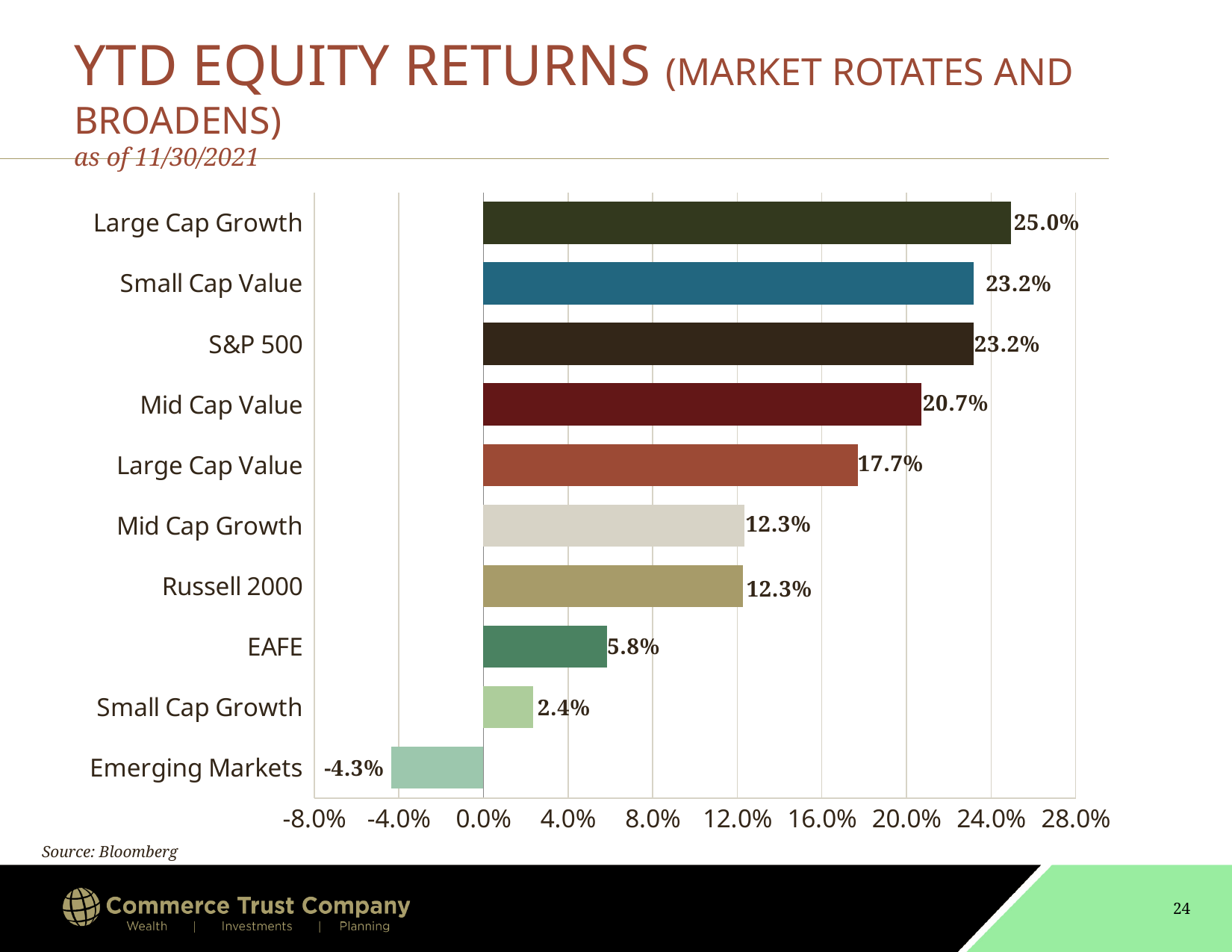
Is the value for Mid Cap Growth greater or less than 8.0%? greater What is the source cited for the chart data? Bloomberg How many categories are shown in the chart? 10 What is the YTD return for Large Cap Growth? 25.0% Which category has the lowest YTD return? Emerging Markets Which category has the highest YTD return? Large Cap Growth What is the YTD return for Mid Cap Value? 20.7% Which has a higher YTD return, EAFE or Small Cap Growth? EAFE What is the YTD return for Emerging Markets? -4.3% What kind of chart is shown on the slide? Bar chart What is the difference between the YTD returns of Large Cap Growth and Large Cap Value? 7.3% How many categories have a negative YTD return? 1